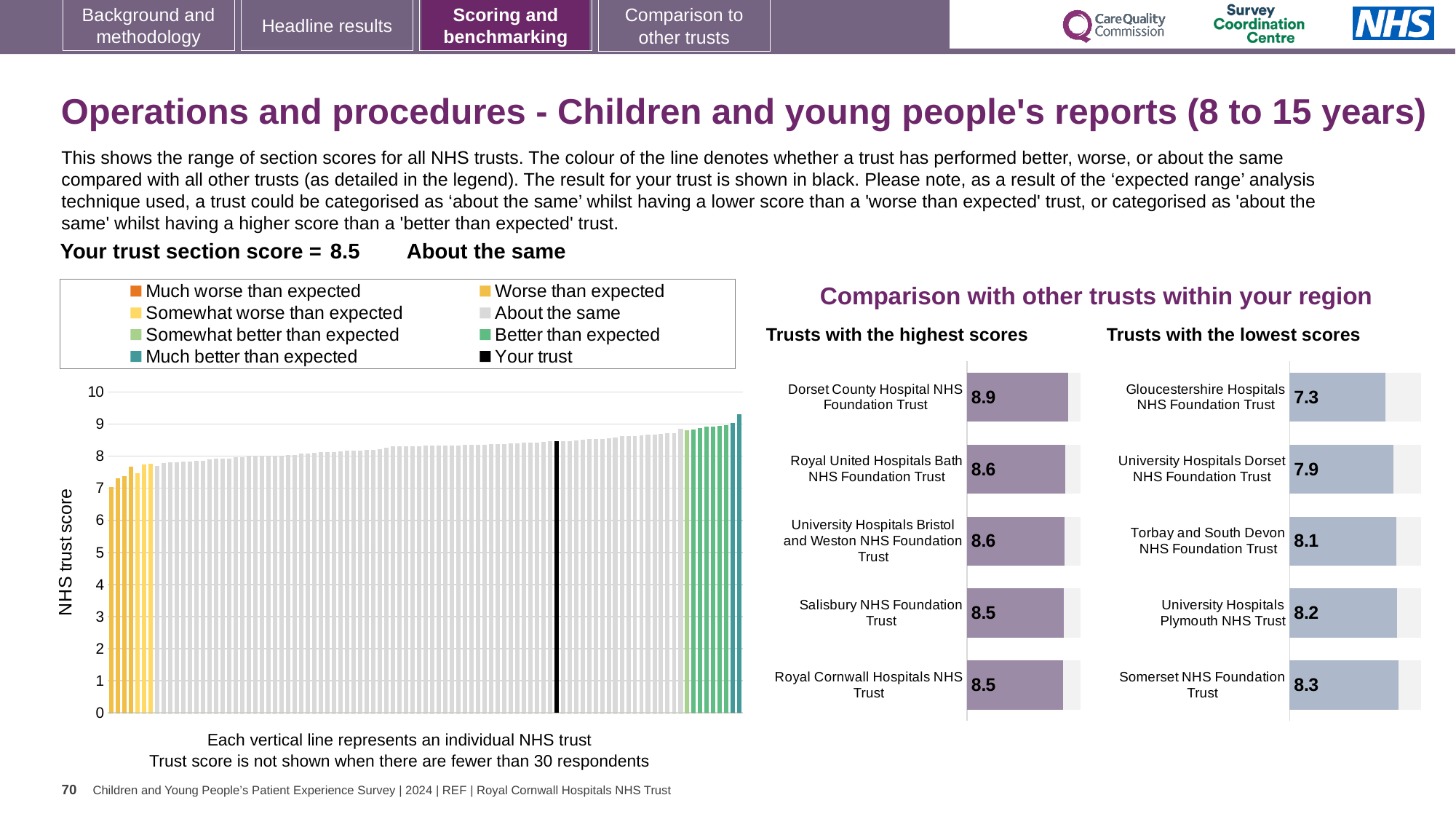
In the 'Trusts with the lowest scores' chart, what is the score for Gloucestershire Hospitals NHS Foundation Trust? 7.3 In the large chart on the left showing all NHS trusts, how many entries does the legend list? 8 In the 'Trusts with the lowest scores' chart, which trust has the lowest score? Gloucestershire Hospitals NHS Foundation Trust In the 'Trusts with the lowest scores' chart, what is the score for Torbay and South Devon NHS Foundation Trust? 8.1 What kind of chart is the large chart on the left showing the NHS trust scores? Bar chart In the 'Trusts with the highest scores' chart, what is the score for Salisbury NHS Foundation Trust? 8.5 In the 'Trusts with the highest scores' chart, what is the difference between the scores of Dorset County Hospital NHS Foundation Trust and Royal Cornwall Hospitals NHS Trust? 0.4 In the 'Trusts with the lowest scores' chart, which has the higher score: University Hospitals Dorset NHS Foundation Trust or University Hospitals Plymouth NHS Trust? University Hospitals Plymouth NHS Trust In the 'Trusts with the highest scores' chart, which trust has the highest score? Dorset County Hospital NHS Foundation Trust How many trusts are shown in the 'Trusts with the highest scores' chart? 5 In the 'Trusts with the highest scores' chart, what is the score for Dorset County Hospital NHS Foundation Trust? 8.9 In the 'Trusts with the lowest scores' chart, what is the difference between the scores of Somerset NHS Foundation Trust and Gloucestershire Hospitals NHS Foundation Trust? 1.0